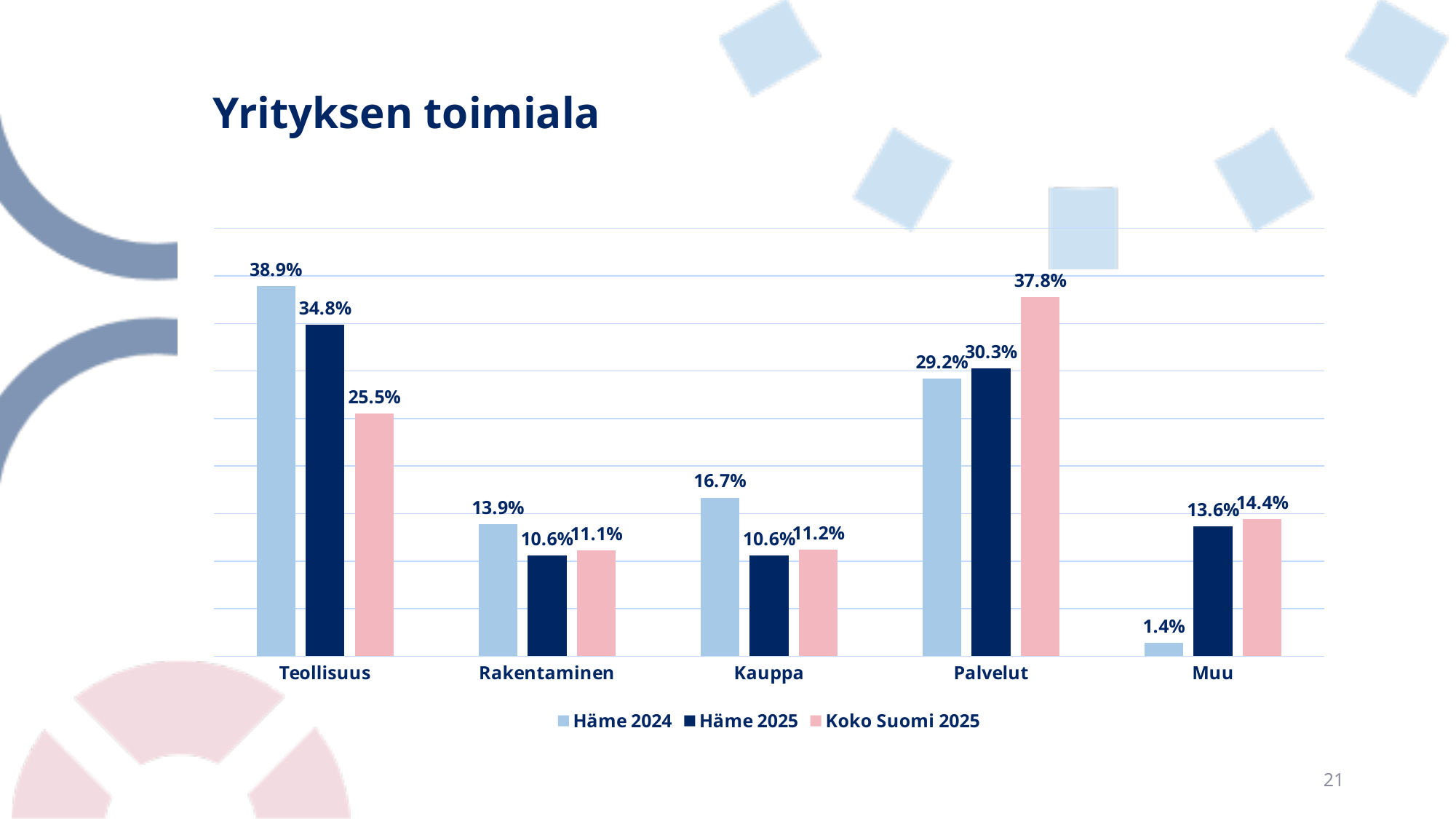
Which category has the lowest value for Koko Suomi 2025? Rakentaminen What is the value for Häme 2025 in the Teollisuus category? 34.8% Which series is shown in pink? Koko Suomi 2025 Which is larger in the Palvelut category: Häme 2024 or Häme 2025? Häme 2025 What is the title of the chart? Yrityksen toimiala What is the difference between Häme 2024 and Häme 2025 in the Teollisuus category? 4.1% How many series does the legend list? 3 How many categories are shown on the x axis? 5 What is the value for Häme 2024 in the Muu category? 1.4% What is the value for Koko Suomi 2025 in the Palvelut category? 37.8% What kind of chart is shown on the slide? Bar chart Which category has the highest value for Häme 2024? Teollisuus